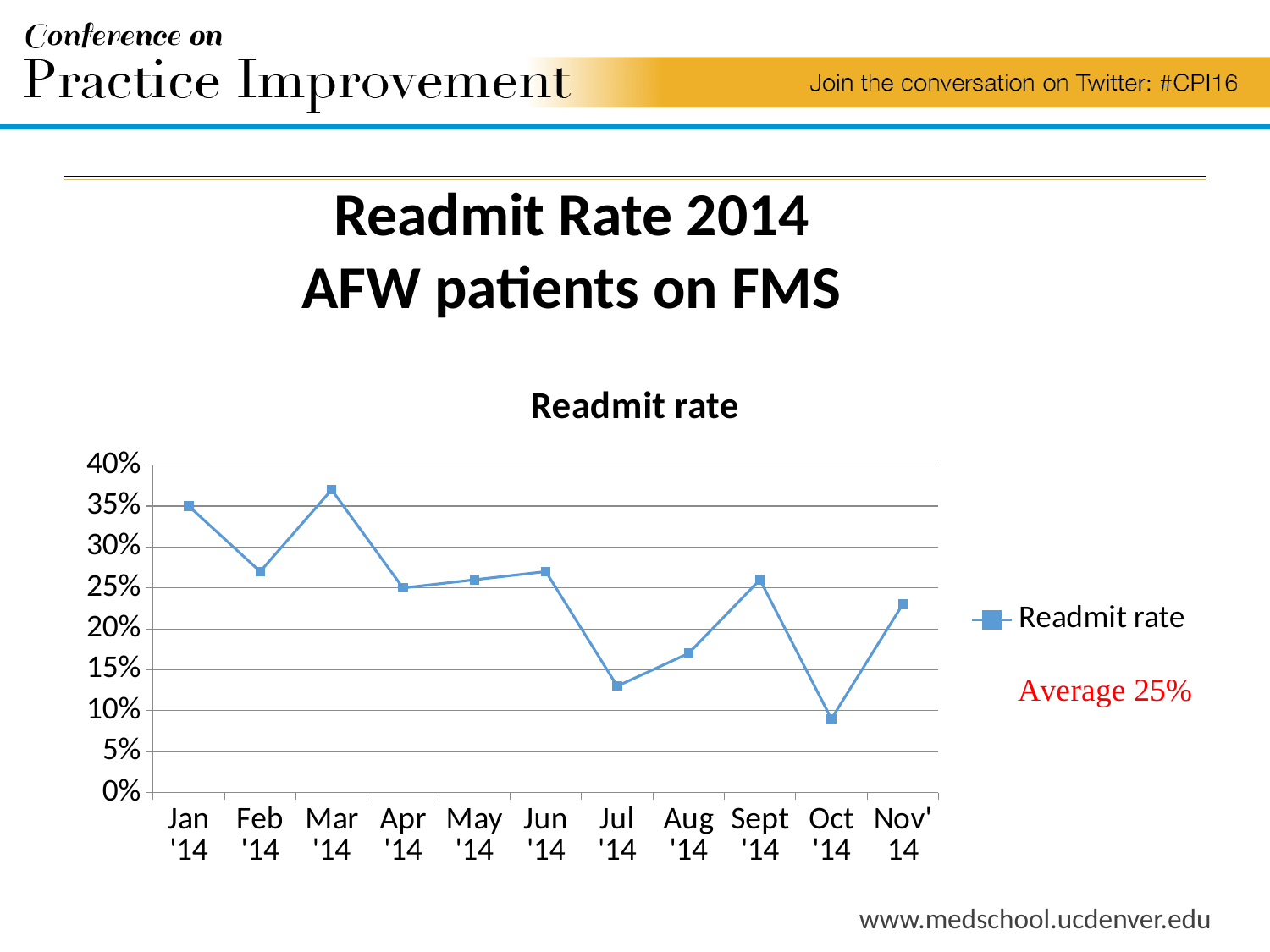
Which month has a higher readmit rate, Feb '14 or Aug '14? Feb '14 Is the readmit rate for Oct '14 greater or less than 10%? less What average readmit rate is noted next to the chart? Average 25% How many months are plotted on the chart? 11 Which month has the highest readmit rate? Mar '14 Which month has the lowest readmit rate? Oct '14 Is the readmit rate for Mar '14 greater or less than 35%? greater What kind of chart is shown on the slide? Line chart How many series does the legend list? 1 What is the readmit rate for Apr '14? 25% Is the readmit rate for Jul '14 greater or less than 15%? less What is the readmit rate for Jan '14? 35%